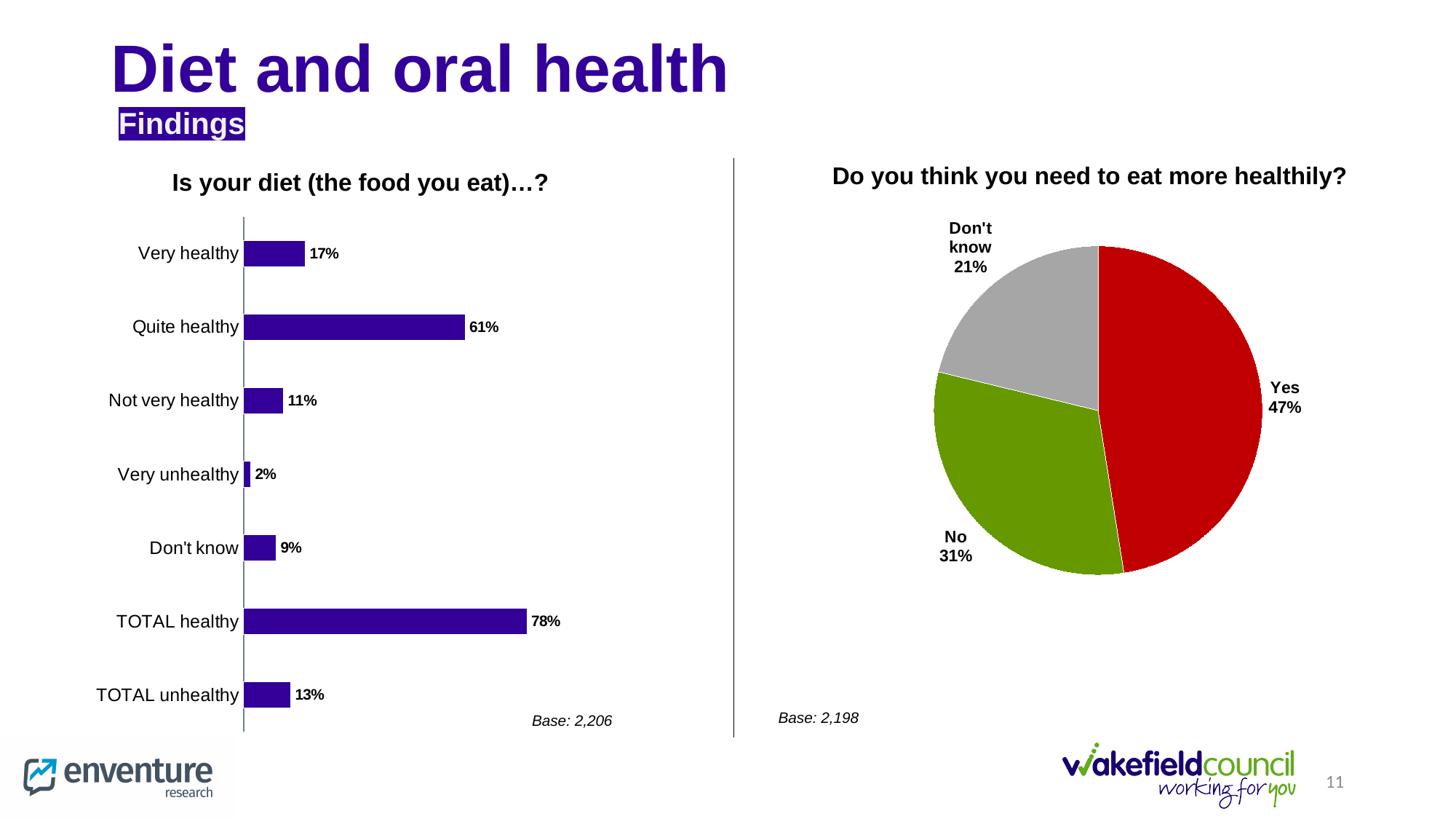
In the 'Do you think you need to eat more healthily?' chart, what share of the pie is No? 31% In the 'Is your diet (the food you eat)…?' chart, what is the value for Very unhealthy? 2% In the 'Do you think you need to eat more healthily?' chart, which slice is the largest? Yes In the 'Is your diet (the food you eat)…?' chart, what is the difference between TOTAL healthy and TOTAL unhealthy? 65% In the 'Is your diet (the food you eat)…?' chart, which is larger: Very healthy or Not very healthy? Very healthy In the 'Is your diet (the food you eat)…?' chart, which category has the highest value? TOTAL healthy In the 'Is your diet (the food you eat)…?' chart, which category has the lowest value? Very unhealthy What kind of chart is 'Do you think you need to eat more healthily?'? Pie chart How many categories are shown in the 'Is your diet (the food you eat)…?' chart? 7 In the 'Is your diet (the food you eat)…?' chart, what is the value for Quite healthy? 61% What kind of chart is 'Is your diet (the food you eat)…?'? Bar chart In the 'Do you think you need to eat more healthily?' chart, what is the difference between Yes and Don't know? 26%